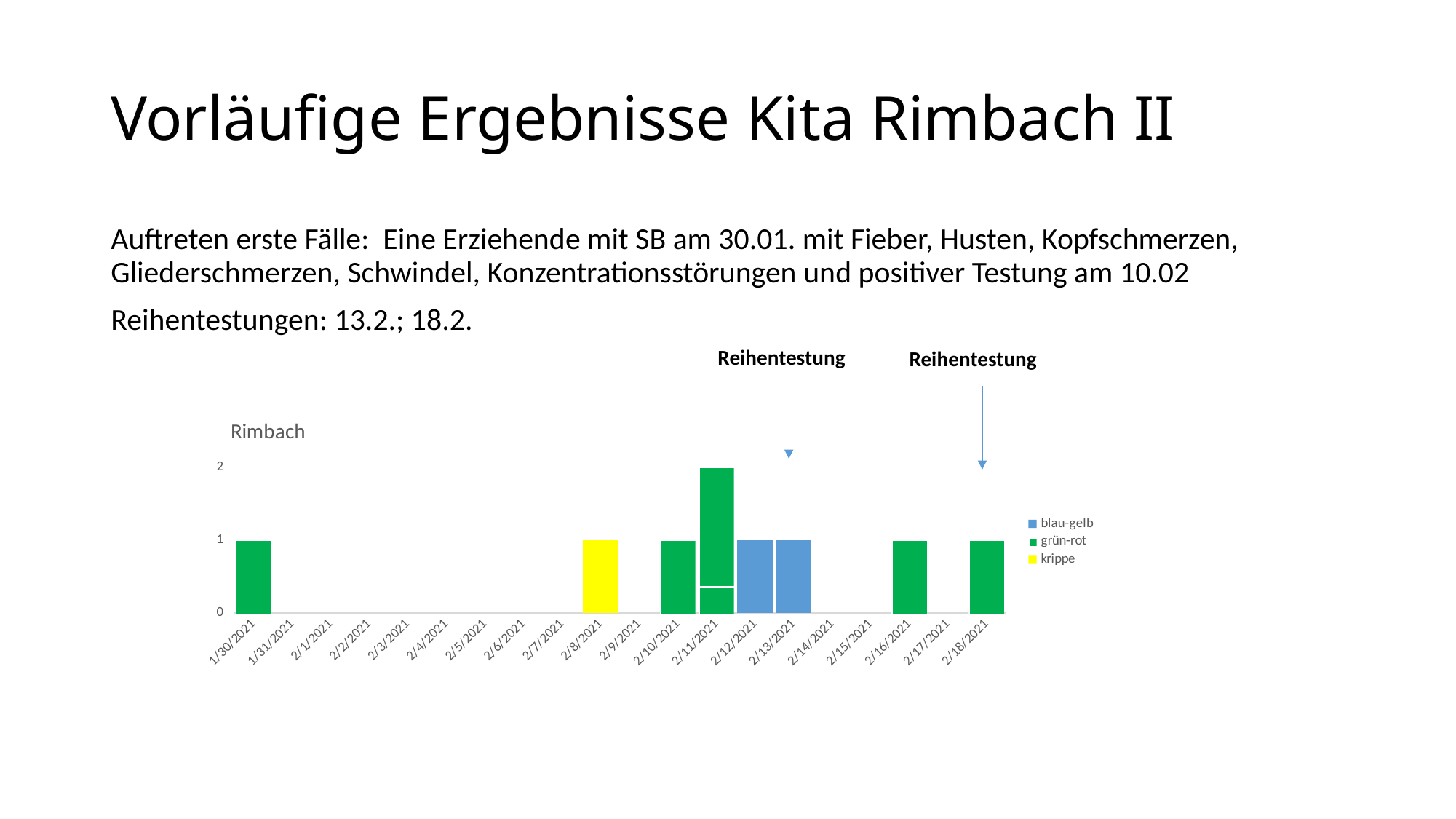
How many dates are shown on the x axis of the chart? 20 What is the value of the bar for 2/13/2021? 1 What is the difference between the bar for 2/11/2021 and the bar for 2/10/2021? 1 How many series does the chart legend list? 3 What is the total height of the stacked bar for 2/11/2021? 2 Which series does the bar on 2/8/2021 belong to? krippe What is the value of the bar for 2/8/2021? 1 Which date has the tallest bar in the chart? 2/11/2021 Which is larger, the bar for 2/11/2021 or the bar for 2/12/2021? 2/11/2021 What is the title of the chart? Rimbach What is the value of the bar for 1/30/2021? 1 What kind of chart is shown on the slide? bar chart